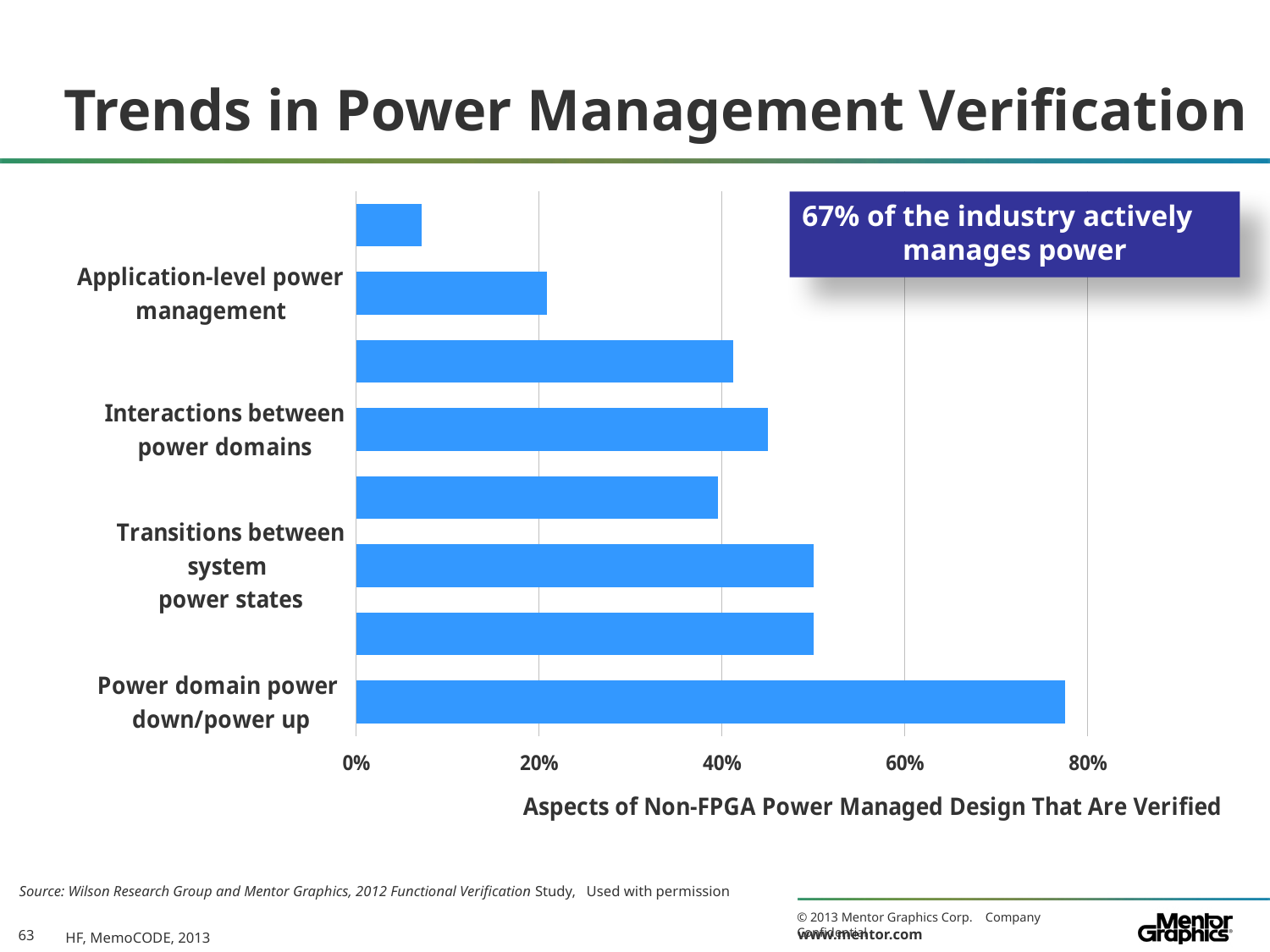
According to the callout box on the chart, what percentage of the industry actively manages power? 67% Is the value of the second bar from the top greater or less than 40%? less Is the value of the shortest bar (the top bar) greater or less than 20%? less Is the value of the bottom bar greater or less than 80%? less What kind of chart is shown on the slide? bar chart Which bar is longer, the top bar or the bottom bar? the bottom bar What is the title shown beneath the chart's horizontal axis? Aspects of Non-FPGA Power Managed Design That Are Verified How many bars are plotted in the chart? 8 What is the highest tick value shown on the horizontal axis? 80%